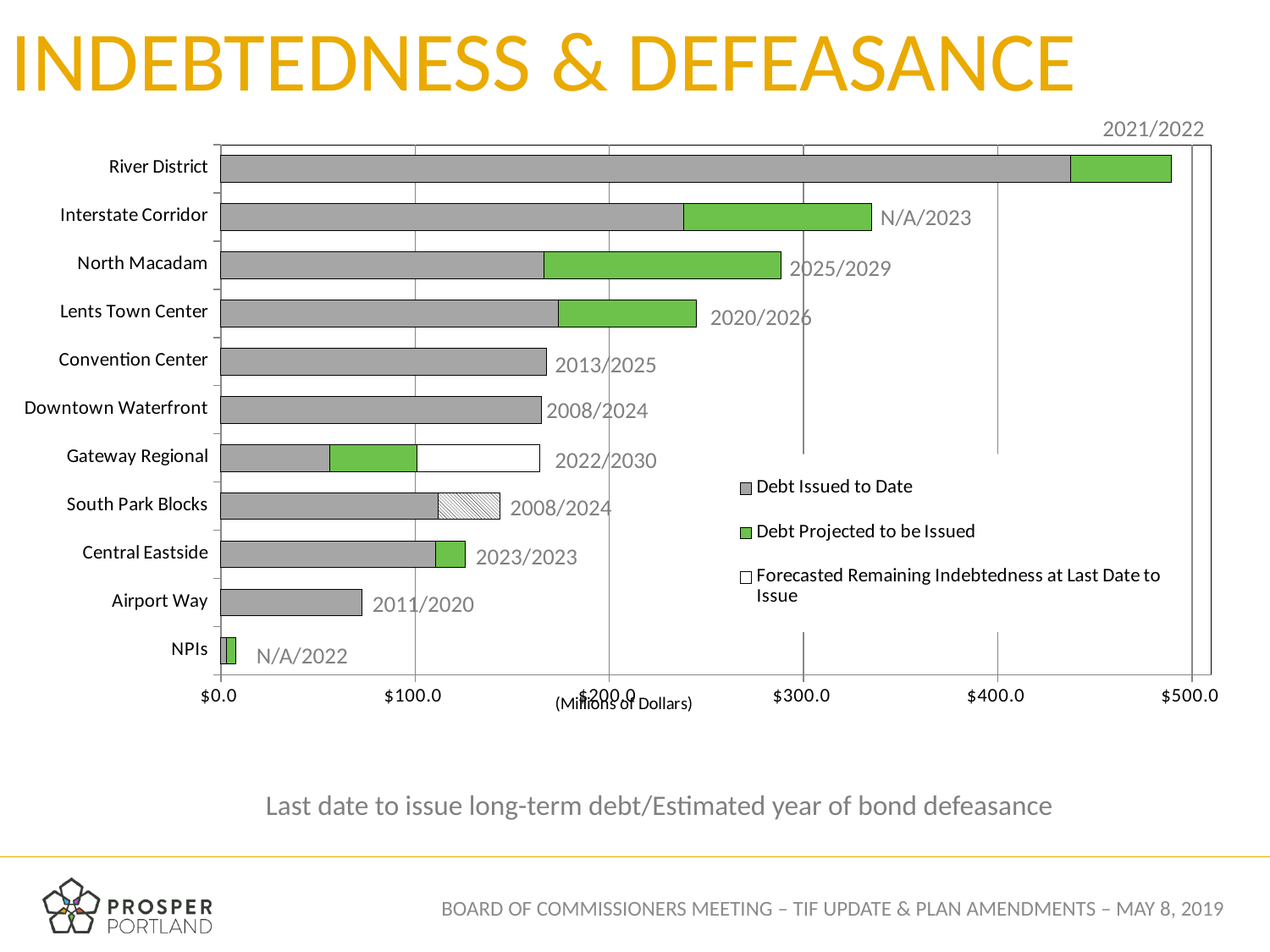
Which has a longer total bar, Central Eastside or Airport Way? Central Eastside What kind of chart is shown on the slide? Bar chart How many urban renewal areas (categories) are listed on the chart? 11 What date label is printed next to the Airport Way bar? 2011/2020 What is the title of the slide containing the chart? INDEBTEDNESS & DEFEASANCE Is the total bar for River District greater or less than $400.0? greater Is the total bar for Interstate Corridor greater or less than $300.0? greater Which category has the longest total bar on the chart? River District Is the total bar for Lents Town Center greater or less than $200.0? greater Which category has the shortest total bar on the chart? NPIs How many series does the chart legend list? 3